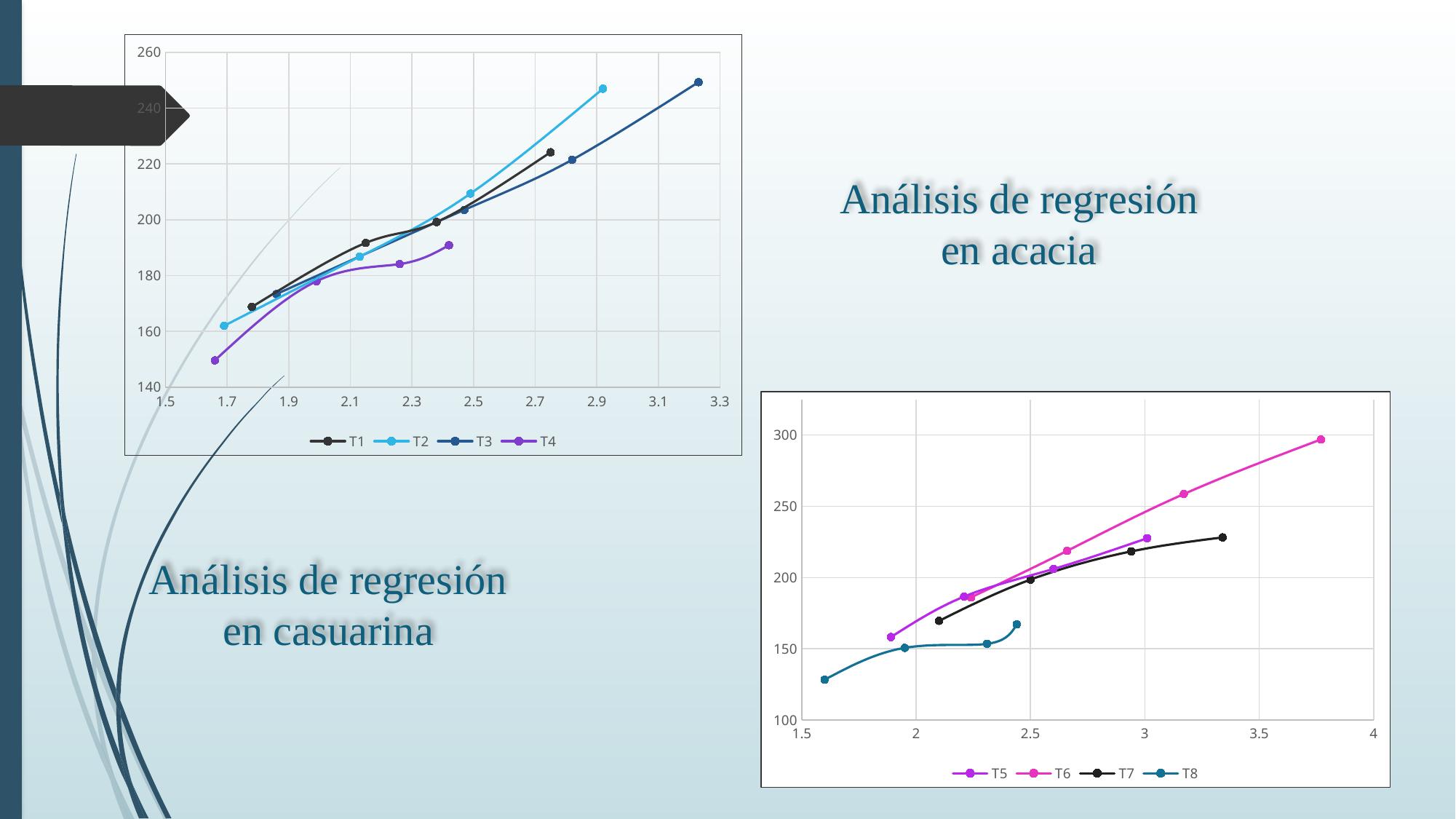
In the 'Análisis de regresión en casuarina' chart, is the highest value of T2 greater or less than 240? greater What type of chart is the 'Análisis de regresión en casuarina' chart? line chart In the 'Análisis de regresión en acacia' chart, how many data points does series T8 have? 4 How many series does the legend of the 'Análisis de regresión en casuarina' chart list? 4 In the 'Análisis de regresión en casuarina' chart, do the values of T1 rise or fall as x increases? rise In the 'Análisis de regresión en acacia' chart, is the highest value of T6 greater or less than 250? greater In the 'Análisis de regresión en acacia' chart, is the lowest value of T8 greater or less than 150? less In the 'Análisis de regresión en casuarina' chart, which series reaches the lowest value? T4 What are the legend entries of the 'Análisis de regresión en acacia' chart? T5, T6, T7, T8 In the 'Análisis de regresión en acacia' chart, which series reaches the highest value? T6